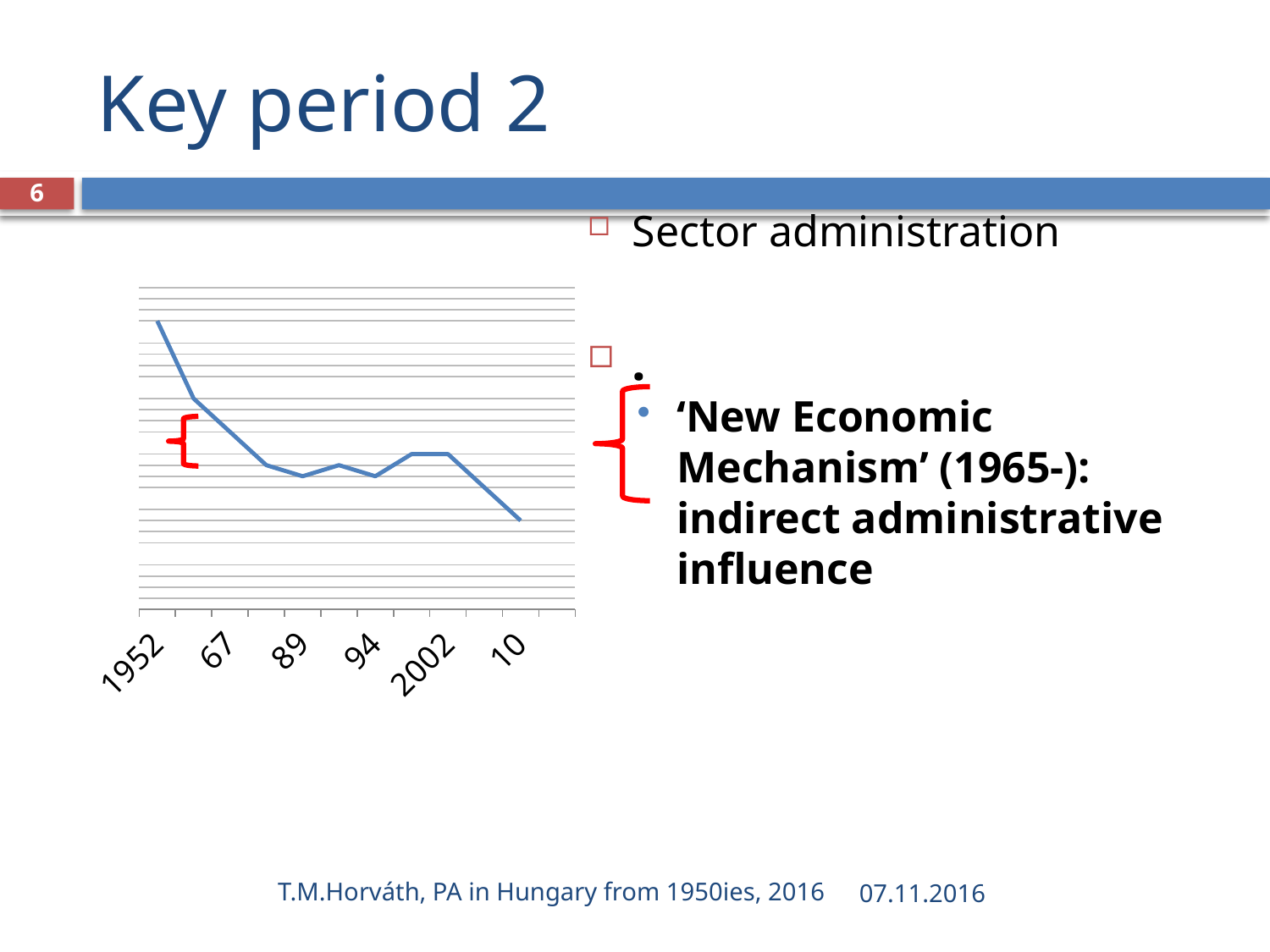
Which has the higher value, 1952 or 67? 1952 Overall, do the values rise or fall from 1952 to 10 along the x axis? fall What is the first label on the x axis of the line chart? 1952 What is the last label on the x axis of the line chart? 10 Which labelled year on the x axis has the lowest value in the line chart? 10 Is the value for 1952 larger or smaller than the value for 10? larger What kind of chart is shown on the slide? line chart Which labelled year on the x axis has the highest value in the line chart? 1952 Which has the higher value, 67 or 94? 67